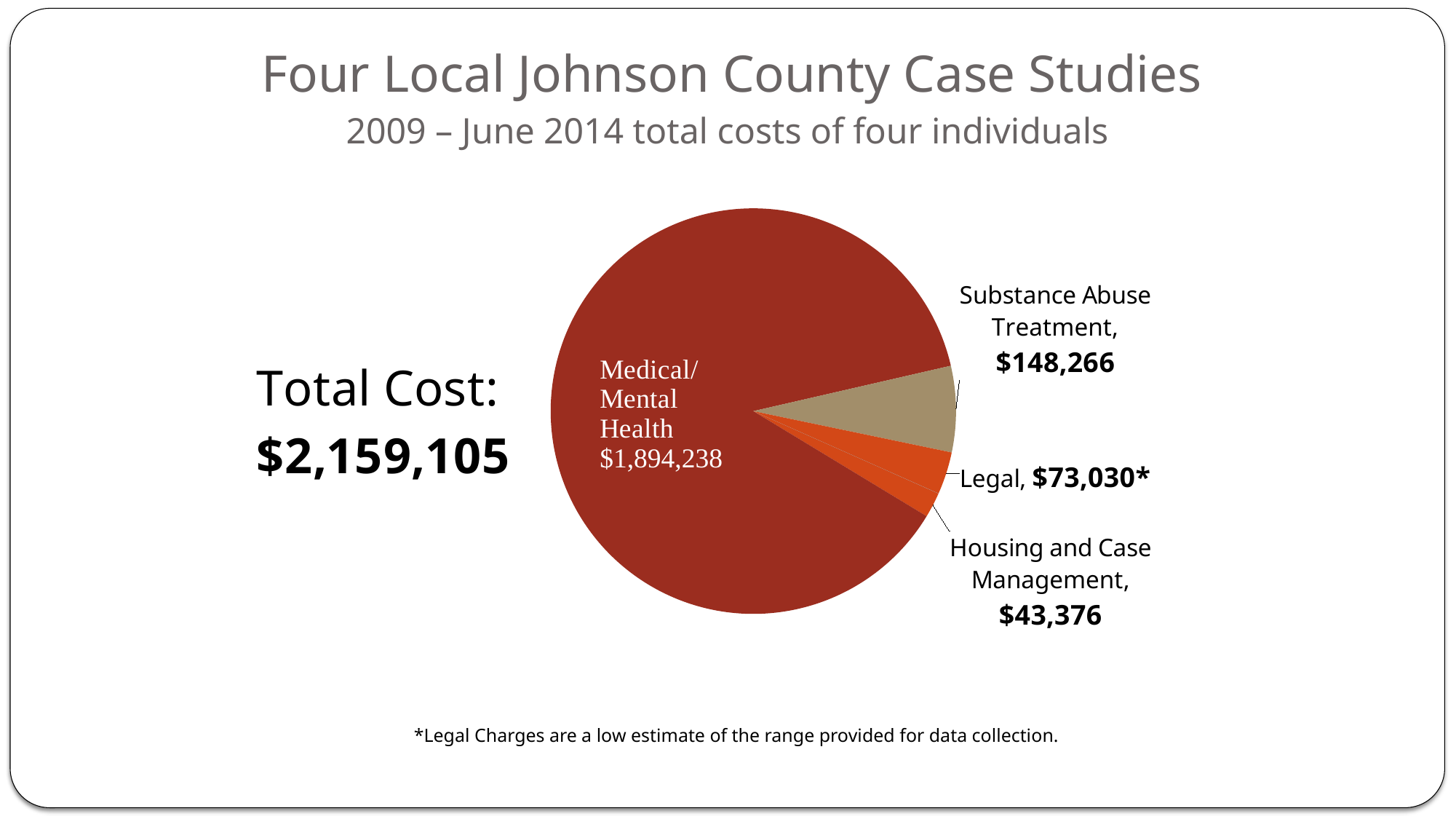
What is the cost shown for Legal? $73,030 What is the difference between the Legal cost and the Housing and Case Management cost? $29,654 What is the difference between the Substance Abuse Treatment cost and the Legal cost? $75,236 What is the cost shown for Substance Abuse Treatment? $148,266 What is the cost shown for Housing and Case Management? $43,376 Which category has the largest slice of the pie? Medical/Mental Health What kind of chart is shown on the slide? pie chart What total cost is stated on the slide next to the pie chart? $2,159,105 Which is larger, the cost for Substance Abuse Treatment or the cost for Legal? Substance Abuse Treatment What is the cost shown for Medical/Mental Health? $1,894,238